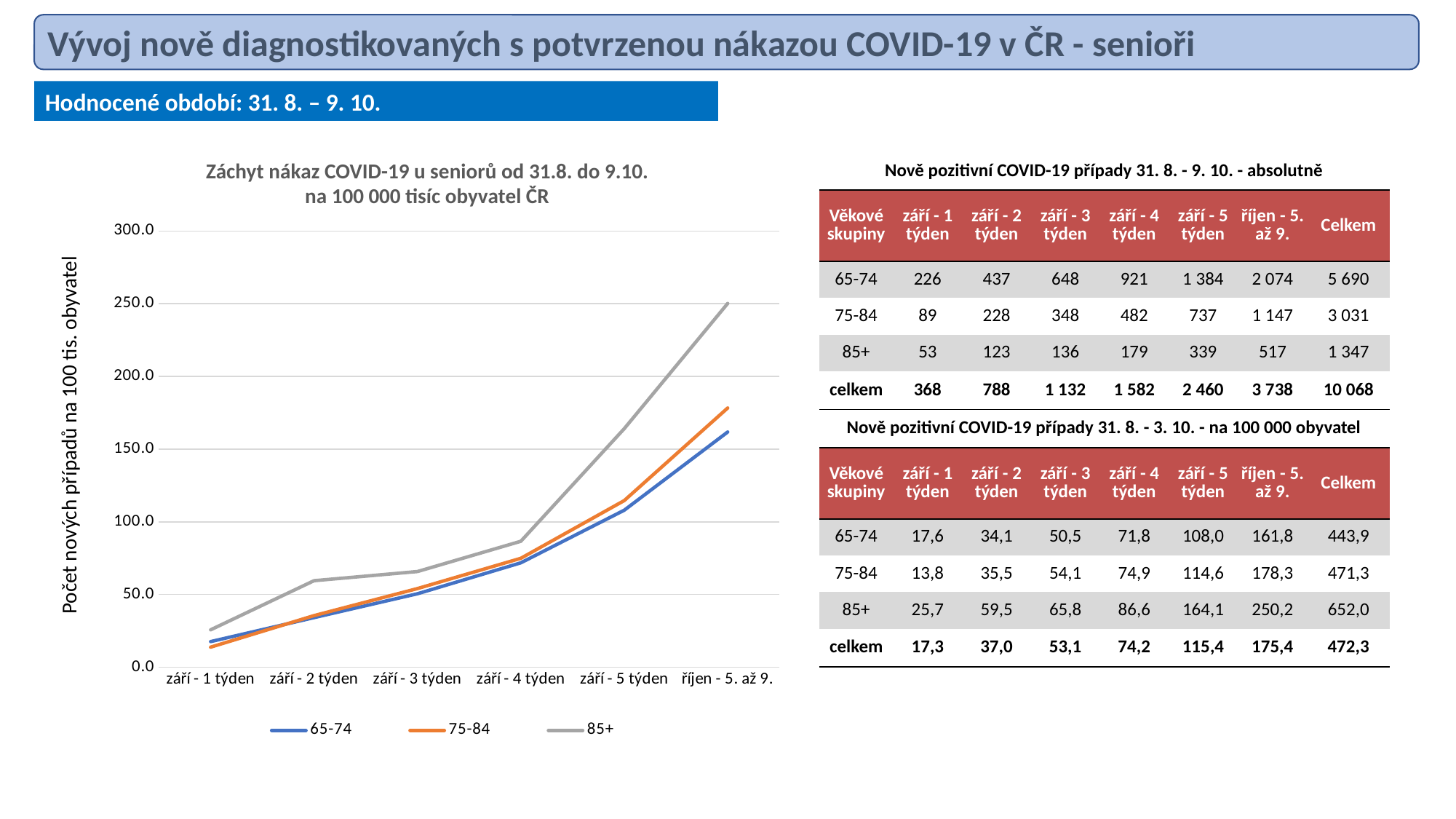
What is the label of the chart's vertical axis? Počet nových případů na 100 tis. obyvatel Is the value for 75-84 in 'říjen - 5. až 9.' greater or less than 200? less Which age group has the highest value in the period 'říjen - 5. až 9.'? 85+ Is the value for 85+ in 'září - 4 týden' greater or less than 100? less How many series does the chart legend list? 3 How many time periods are shown along the x axis of the chart? 6 Which age group has the lowest value in the period 'říjen - 5. až 9.'? 65-74 In 'září - 2 týden', which series has the larger value, 85+ or 65-74? 85+ What kind of chart is shown on the slide? line chart Is the value for 85+ in 'září - 5 týden' greater or less than 150? greater Do the values for the 85+ series rise or fall from 'září - 1 týden' to 'říjen - 5. až 9.'? rise